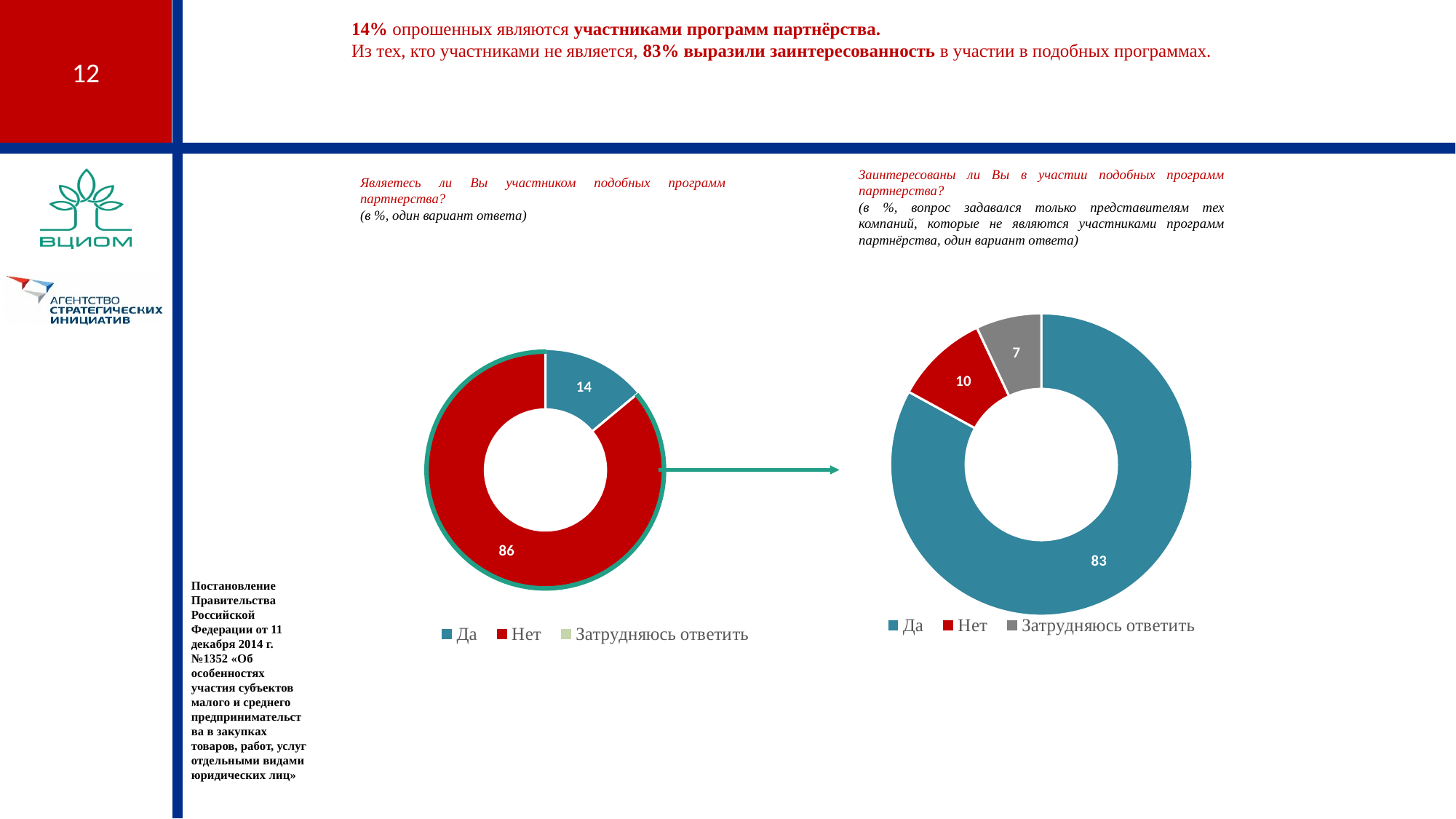
In the left chart, what is the value for "Да"? 14 In the right chart, what is the value for "Да"? 83 What type of chart is the right chart? Pie (donut) chart In the right chart, what is the value for "Затрудняюсь ответить"? 7 In the left chart, which category has the largest slice? Нет In the left chart, what is the difference between the values for "Нет" and "Да"? 72 In the right chart, which is larger, the value for "Нет" or the value for "Затрудняюсь ответить"? Нет In the right chart, what is the value for "Нет"? 10 In the left chart, what is the value for "Нет"? 86 In the right chart, which category has the smallest slice? Затрудняюсь ответить How many entries does the legend of the left chart list? 3 In the right chart, which category has the largest slice? Да